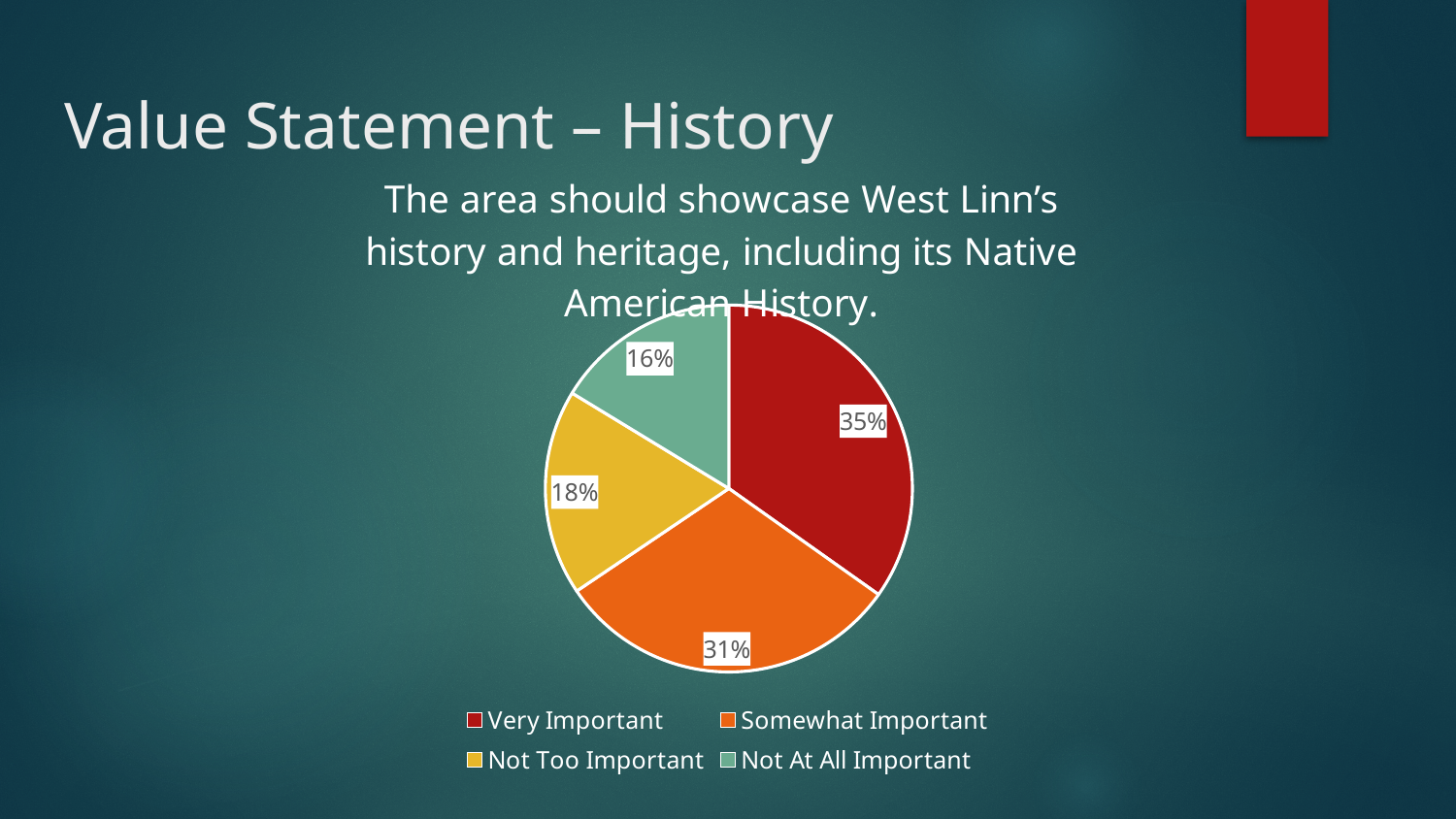
What share of the pie is labelled Not At All Important? 16% What colour is the Somewhat Important slice? orange Which category has the largest slice of the pie? Very Important What is the combined share of the Very Important and Somewhat Important slices? 66% What is the difference in percentage points between the Very Important and Somewhat Important slices? 4 Which category has the smallest slice of the pie? Not At All Important What share of the pie is labelled Somewhat Important? 31% What share of the pie is labelled Very Important? 35% Which slice is larger, Not Too Important or Not At All Important? Not Too Important What share of the pie is labelled Not Too Important? 18% How many categories does the legend list? 4 What kind of chart is shown on the slide? pie chart